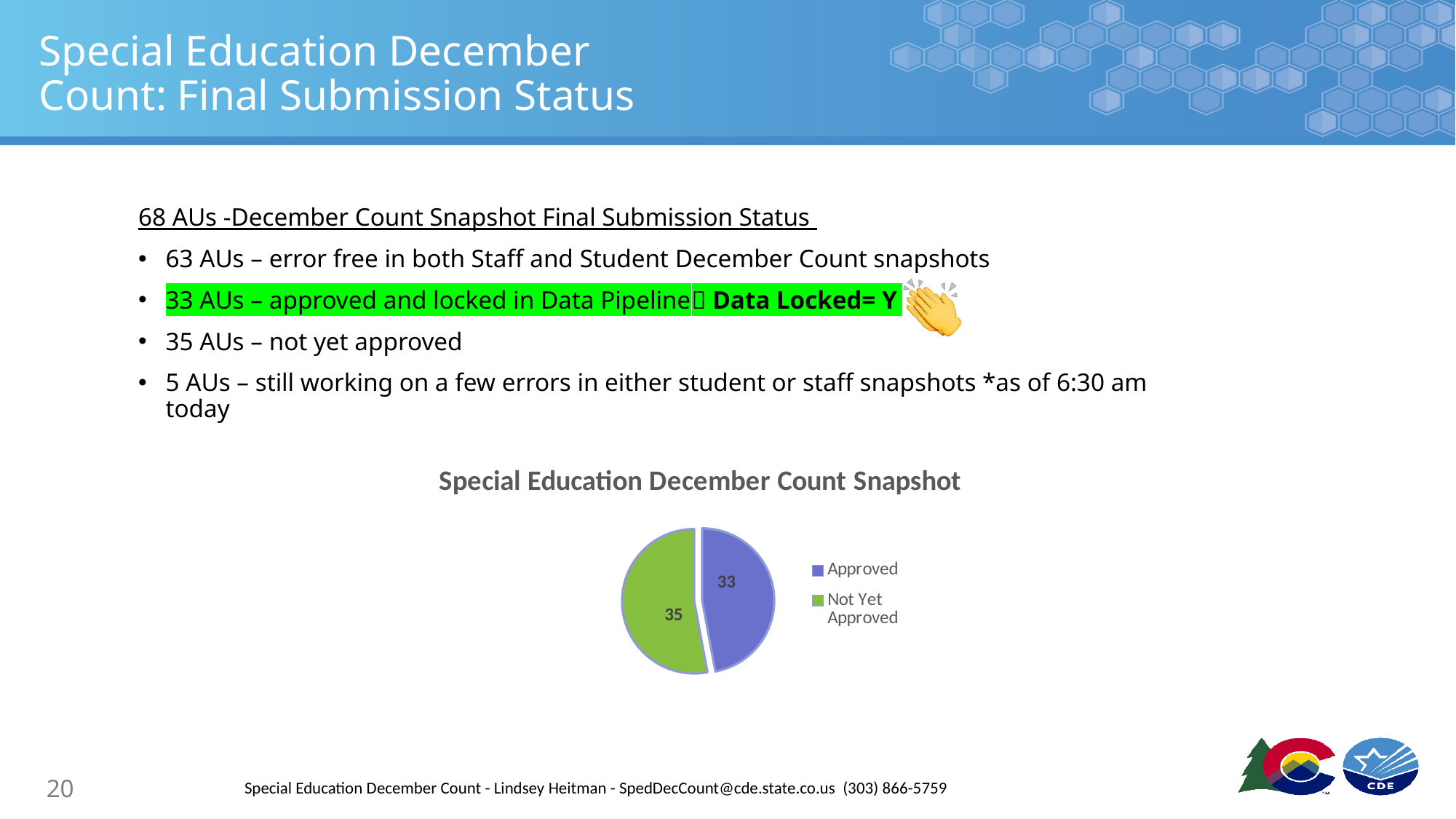
Which slice of the pie chart is the smallest? Approved What is the total of the two slices in the pie chart? 68 What kind of chart is shown on the slide? pie chart How many entries does the legend list? 2 What is the value for Approved in the pie chart? 33 What is the title of the chart? Special Education December Count Snapshot What is the value for Not Yet Approved in the pie chart? 35 What colour is the Not Yet Approved slice? green How many slices does the pie chart have? 2 Which slice of the pie chart is the largest? Not Yet Approved What is the difference between the Not Yet Approved and Approved values? 2 Which is larger, Approved or Not Yet Approved? Not Yet Approved